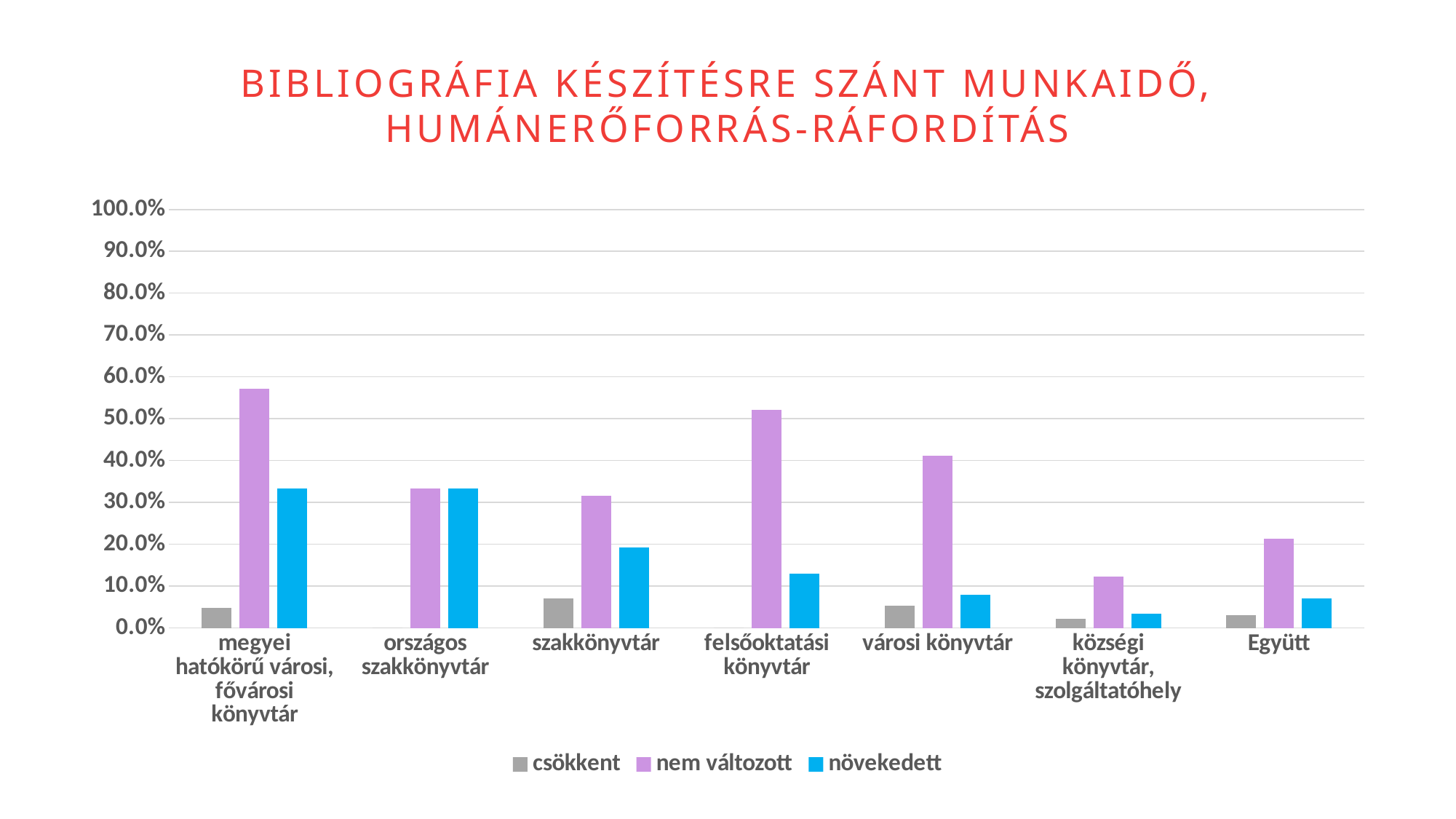
Which category has the lowest 'növekedett' bar? községi könyvtár, szolgáltatóhely For városi könyvtár, which is larger: the 'nem változott' bar or the 'növekedett' bar? nem változott How many library categories are shown on the x axis? 7 Is the 'nem változott' value for Együtt greater or less than 30%? less Is the 'nem változott' value for megyei hatókörű városi, fővárosi könyvtár greater or less than 50%? greater How many series does the legend list? 3 What are the three legend entries of the chart? csökkent, nem változott, növekedett Which category has the highest 'nem változott' bar? megyei hatókörű városi, fővárosi könyvtár Which has the larger 'növekedett' value: szakkönyvtár or felsőoktatási könyvtár? szakkönyvtár What kind of chart is shown on the slide? bar chart Is the 'nem változott' value for felsőoktatási könyvtár greater or less than 50%? greater